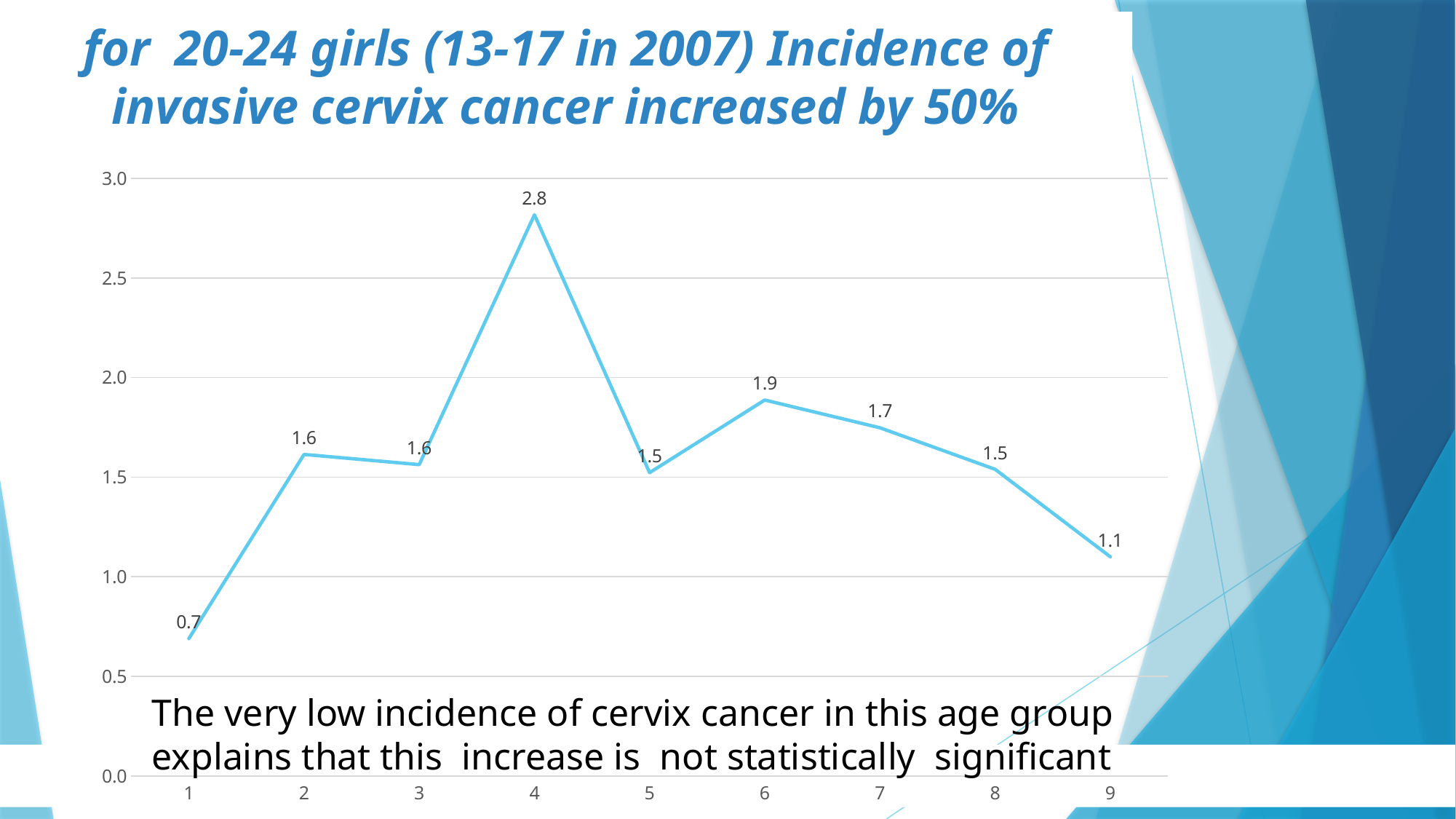
What is the value at point 9? 1.1 Which point on the x axis has the highest value? 4 Is the value at point 4 greater or less than 2.5? greater Which point on the x axis has the lowest value? 1 What is the value at point 1? 0.7 How many data points are plotted on the line? 9 What is the value at point 6? 1.9 Which is larger, the value at point 6 or the value at point 7? point 6 What type of chart is shown on the slide? line chart What is the difference between the value at point 4 and the value at point 1? 2.1 Does the line rise or fall from point 6 to point 9? fall What is the value at point 4? 2.8